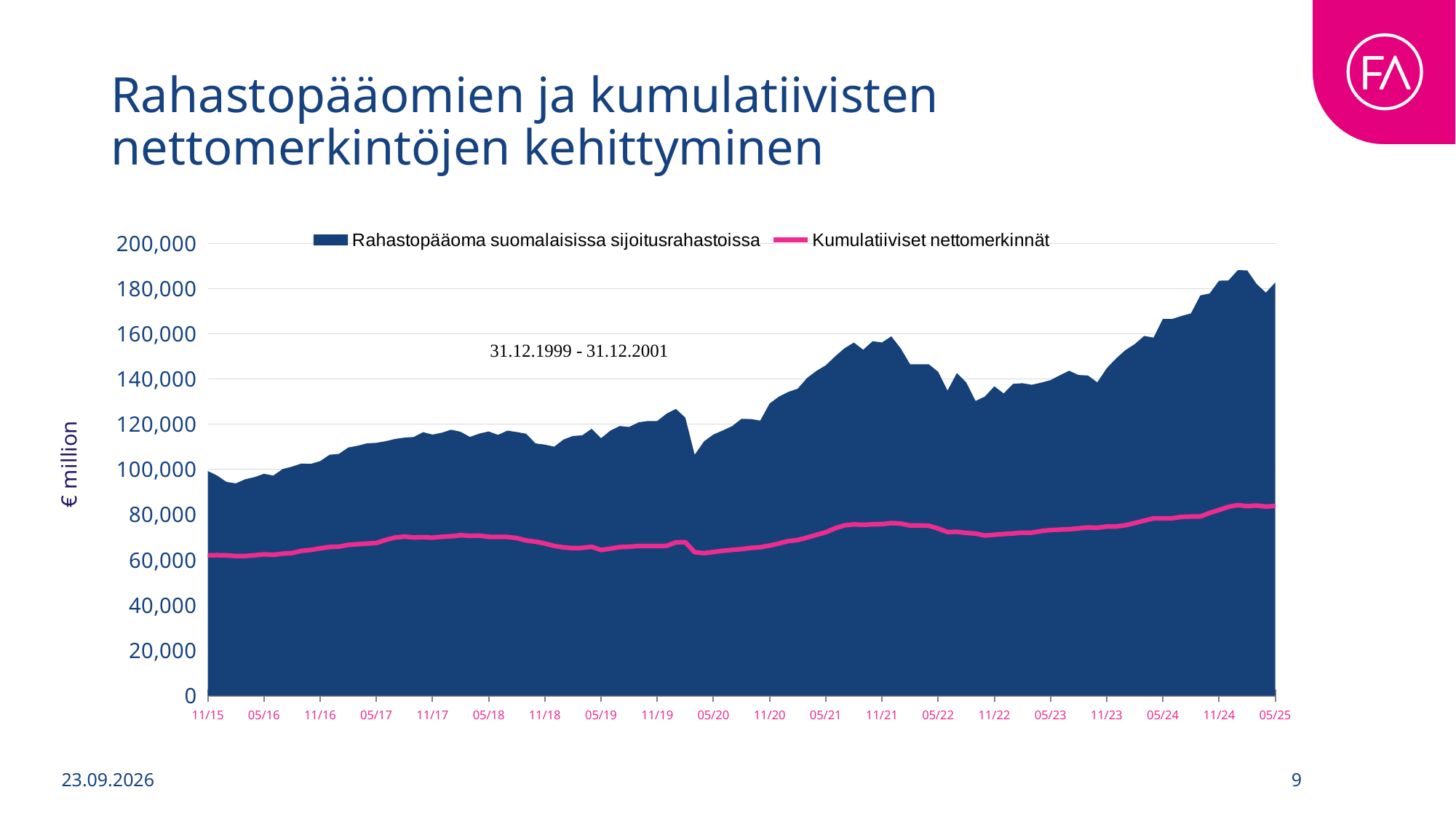
Is the value of Kumulatiiviset nettomerkinnät at 05/25 greater or less than 100,000? less At 05/25, which series has the larger value: Rahastopääoma suomalaisissa sijoitusrahastoissa or Kumulatiiviset nettomerkinnät? Rahastopääoma suomalaisissa sijoitusrahastoissa Overall, does Rahastopääoma suomalaisissa sijoitusrahastoissa rise or fall from 11/15 to 05/25? rise What is the name of the series drawn as the dark blue filled area? Rahastopääoma suomalaisissa sijoitusrahastoissa What kind of chart is shown on the slide? Area chart with a line series Is the highest value reached by Rahastopääoma suomalaisissa sijoitusrahastoissa greater or less than 180,000? greater How many series does the chart legend list? 2 How many date labels are shown on the x axis? 20 Is the value of Kumulatiiviset nettomerkinnät at 11/15 greater or less than 80,000? less What unit is shown on the vertical axis label? € million